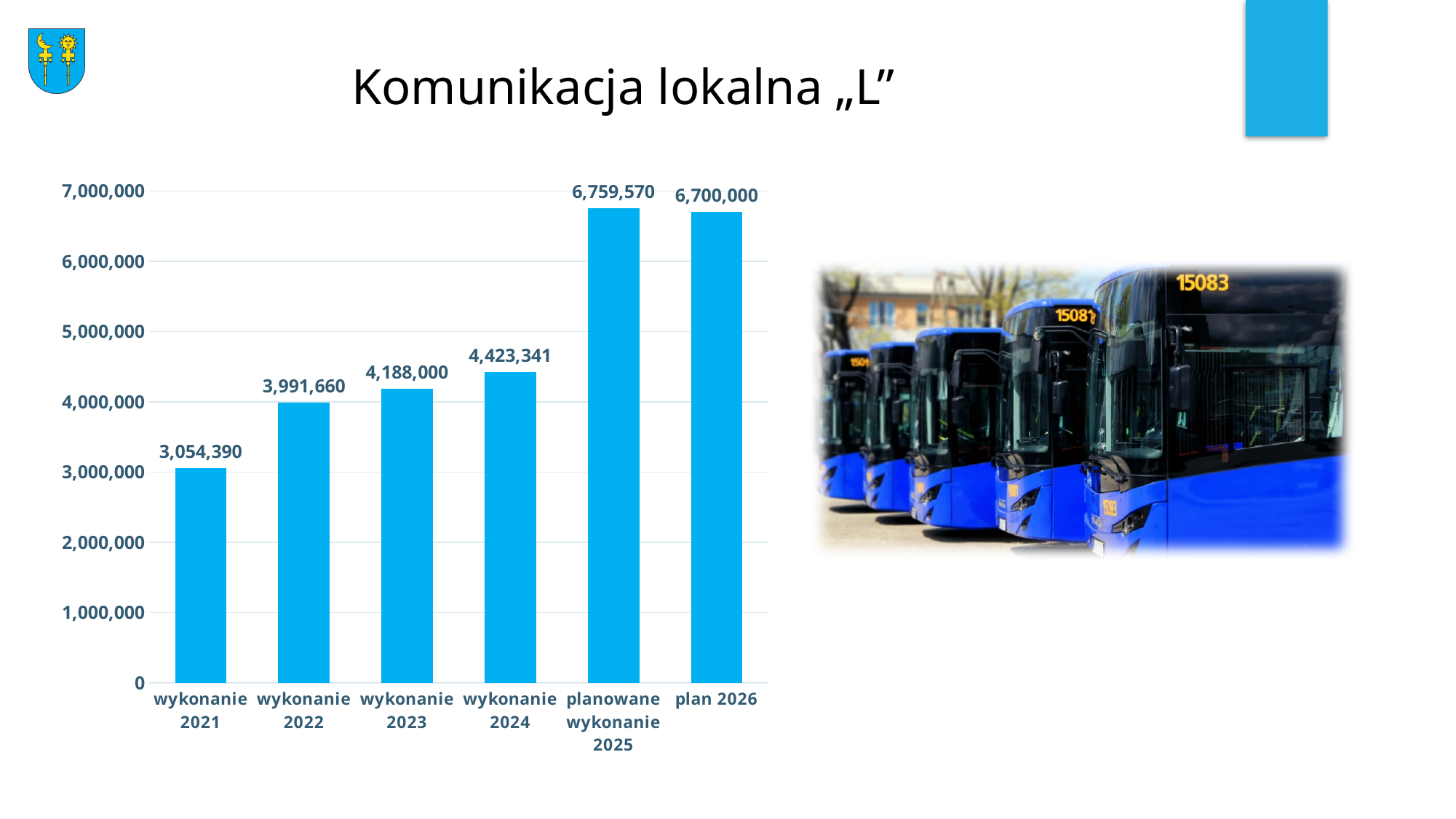
What is the value for plan 2026? 6,700,000 Which category has the highest value? planowane wykonanie 2025 What kind of chart is shown on the slide? bar chart Which category has the lowest value? wykonanie 2021 What is the value for planowane wykonanie 2025? 6,759,570 Do the values rise or fall from wykonanie 2021 to wykonanie 2024? rise Which is larger, wykonanie 2022 or wykonanie 2024? wykonanie 2024 How many categories are shown on the chart? 6 What is the value for wykonanie 2023? 4,188,000 What is the difference between planowane wykonanie 2025 and plan 2026? 59,570 What is the difference between wykonanie 2024 and wykonanie 2023? 235,341 What is the value for wykonanie 2021? 3,054,390